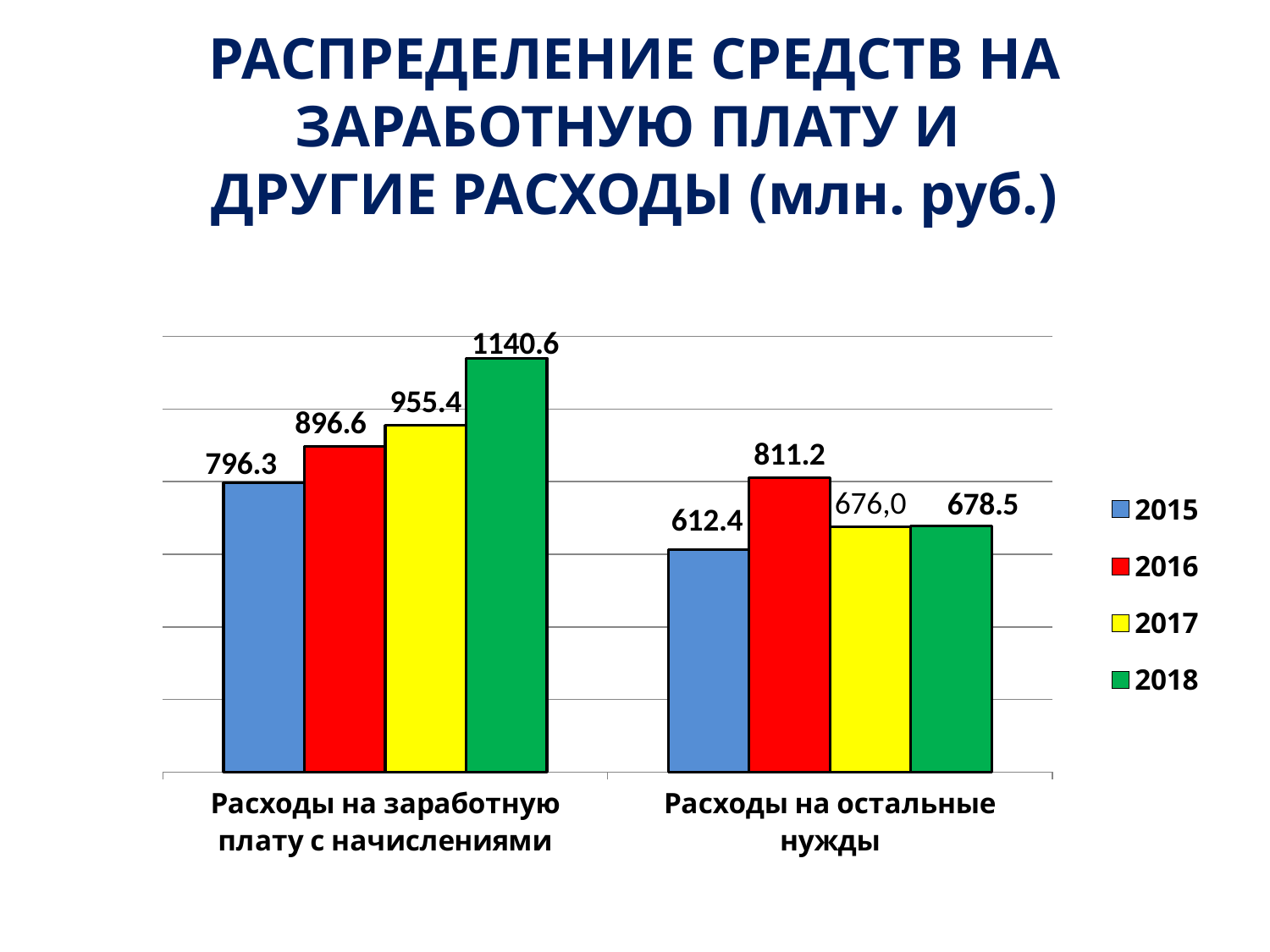
What is the value for 2018 in the category 'Расходы на заработную плату с начислениями'? 1140.6 What is the difference between the 2018 and 2015 values in the category 'Расходы на заработную плату с начислениями'? 344.3 How many series does the legend list? 4 Which year has the highest value in the category 'Расходы на заработную плату с начислениями'? 2018 How many categories are shown on the x axis? 2 What is the value for 2015 in the category 'Расходы на остальные нужды'? 612.4 Which year has the lowest value in the category 'Расходы на остальные нужды'? 2015 Do the values for 'Расходы на заработную плату с начислениями' rise or fall from 2015 to 2018? rise Which is larger: the 2016 value or the 2017 value in the category 'Расходы на остальные нужды'? 2016 What is the value for 2016 in the category 'Расходы на остальные нужды'? 811.2 What type of chart is shown on the slide? bar chart What colour represents the 2017 series in the legend? yellow